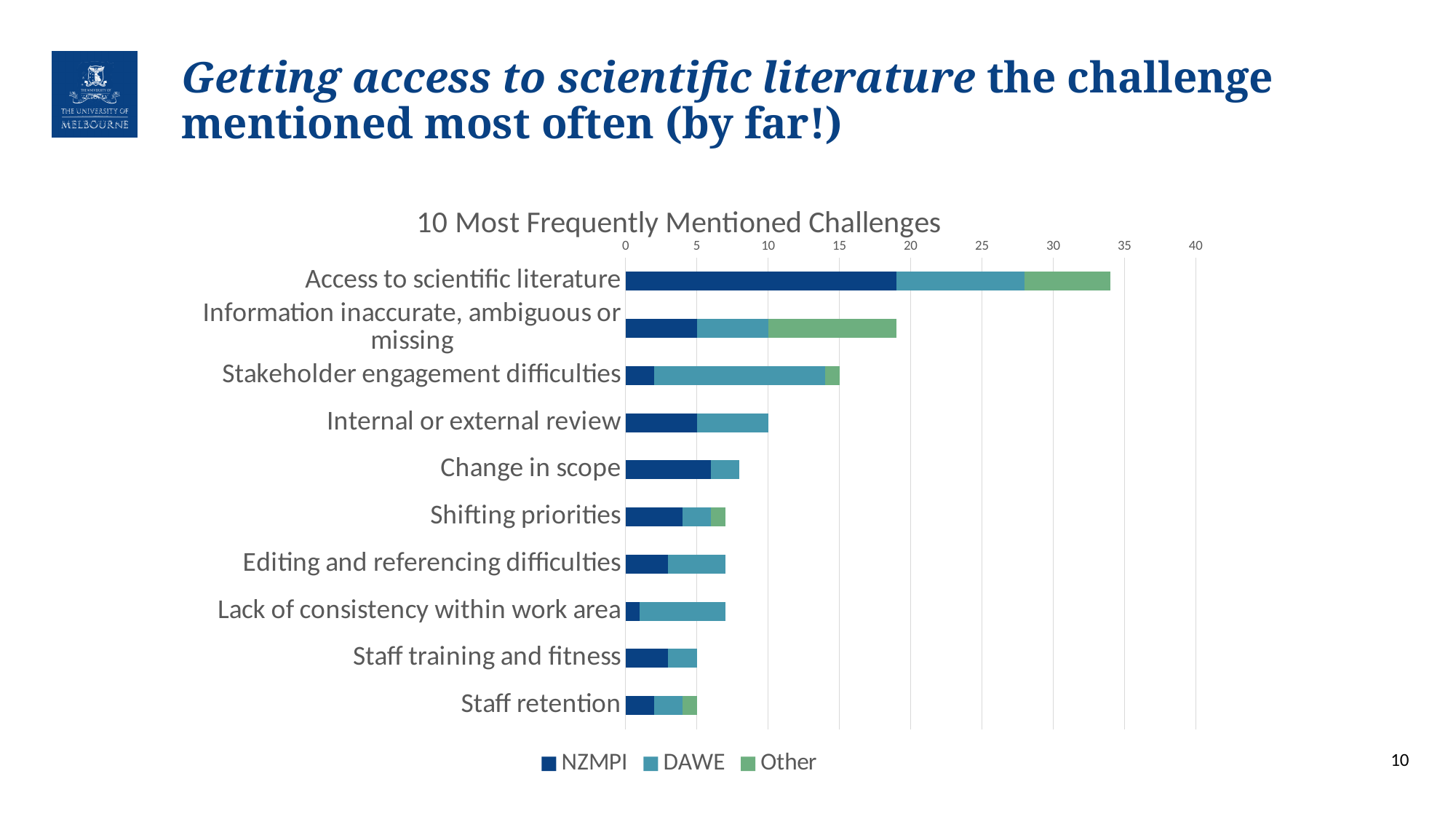
Which has a larger total: Stakeholder engagement difficulties or Shifting priorities? Stakeholder engagement difficulties Which series are listed in the legend? NZMPI, DAWE, Other Is the total value for Access to scientific literature greater or less than 30? greater What is the total value for Internal or external review? 10 Which has a larger total: Access to scientific literature or Information inaccurate, ambiguous or missing? Access to scientific literature Is the total value for Information inaccurate, ambiguous or missing greater or less than 20? less Is the total value for Change in scope greater or less than 10? less What is the title of the chart? 10 Most Frequently Mentioned Challenges Which challenge has the highest total number of mentions? Access to scientific literature What kind of chart is shown on the slide? Bar chart How many challenges (categories) are plotted in the chart? 10 How many series does the legend list? 3